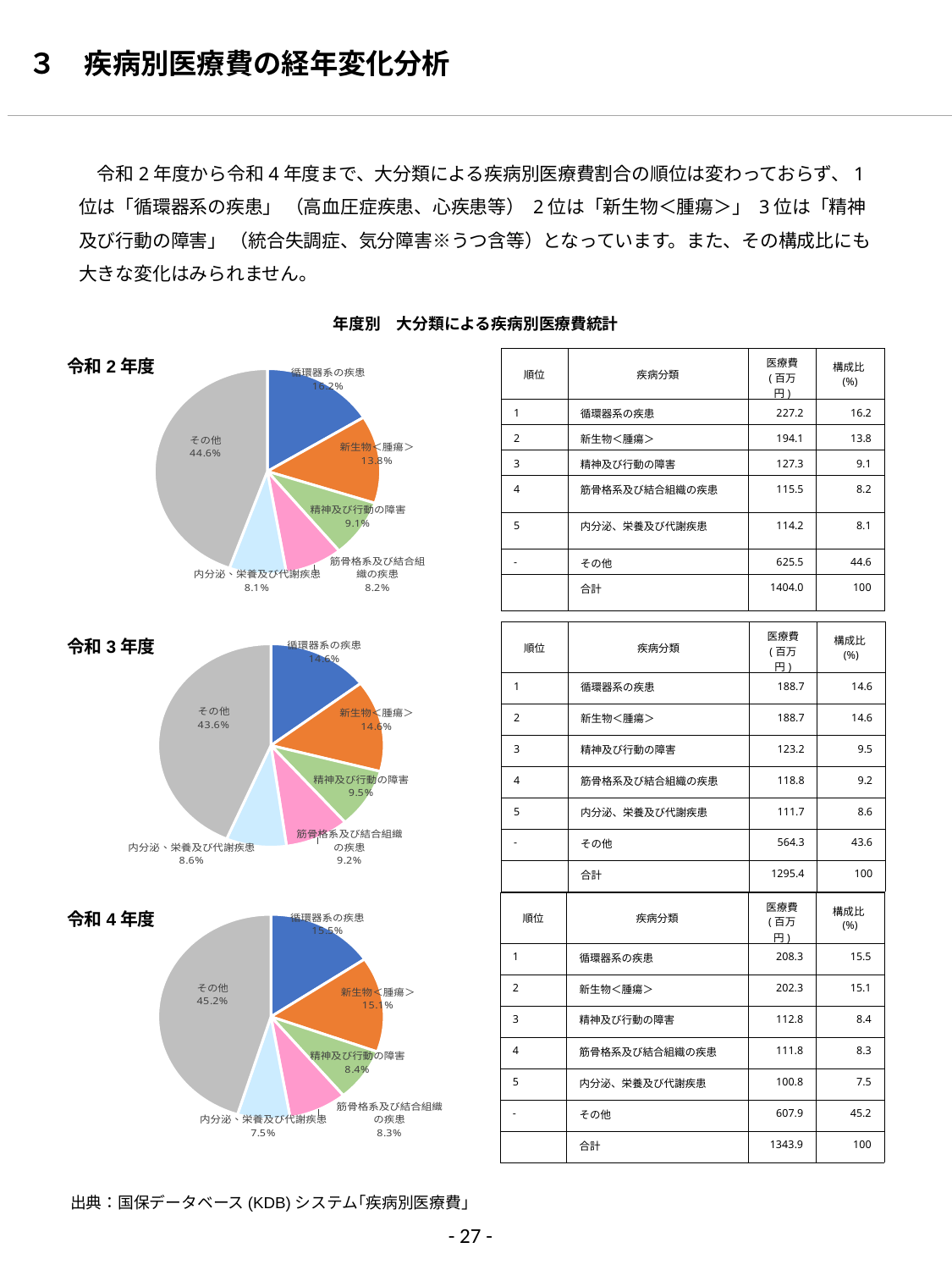
In the 令和2年度 pie chart, which slice has the largest share? その他 What kind of chart is used for 令和2年度? Pie chart In the 令和3年度 pie chart, what share is labelled for 精神及び行動の障害? 9.5% How many pie charts are shown on the slide? 3 In the 令和4年度 pie chart, which slice has the smallest share? 内分泌、栄養及び代謝疾患 How many slices does the 令和4年度 pie chart have? 6 In the 令和3年度 pie chart, what share is labelled for 内分泌、栄養及び代謝疾患? 8.6% In the 令和4年度 pie chart, what share is labelled for 新生物＜腫瘍＞? 15.1% What is the title printed above the group of pie charts? 年度別 大分類による疾病別医療費統計 In the 令和2年度 pie chart, what is the difference in percentage points between 循環器系の疾患 and 新生物＜腫瘍＞? 2.4 In the 令和2年度 pie chart, what share is labelled for その他? 44.6% In the 令和4年度 pie chart, which has the larger share, 循環器系の疾患 or 新生物＜腫瘍＞? 循環器系の疾患